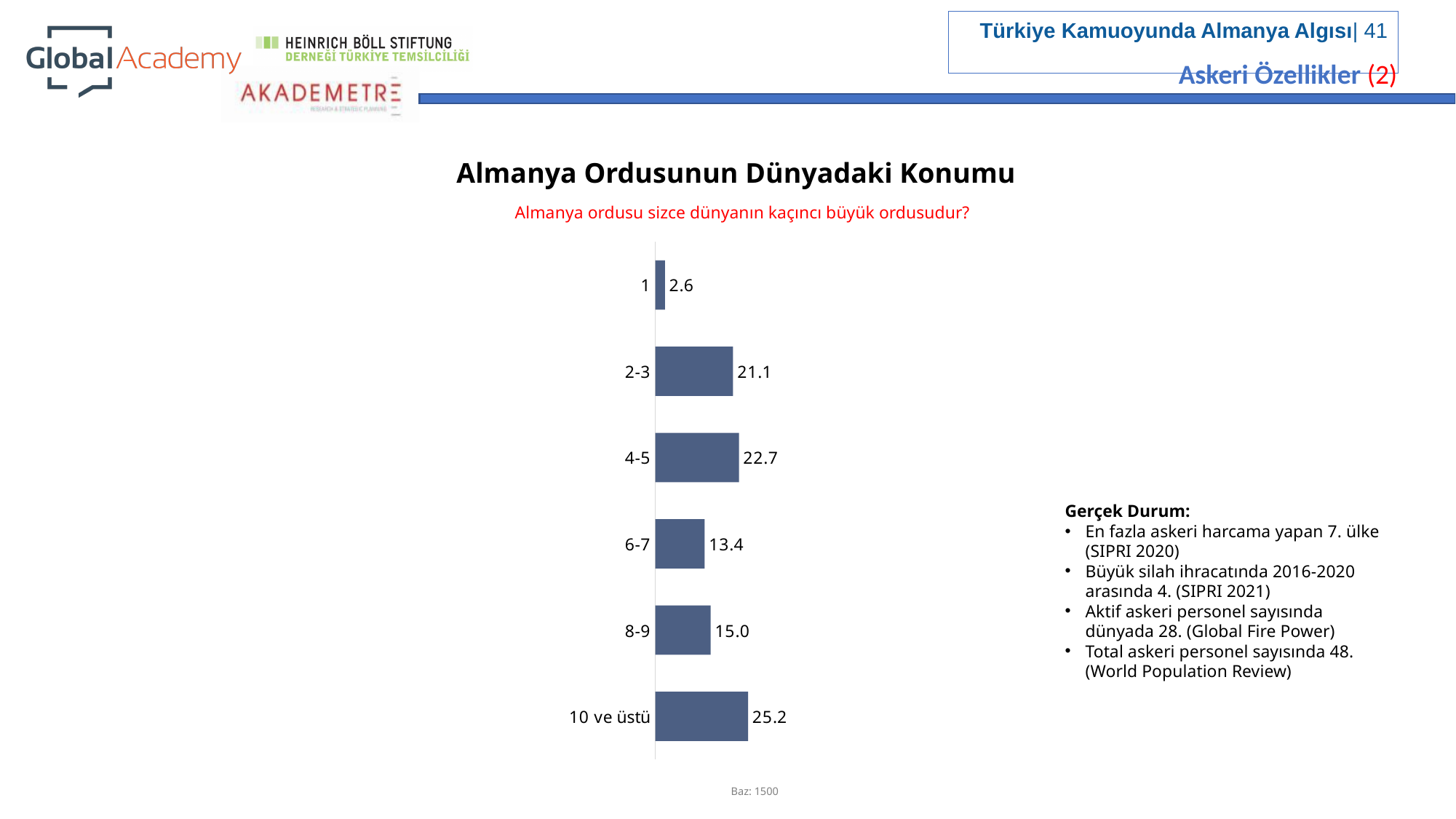
What kind of chart is shown on the slide? bar chart Which category has the lowest value? 1 What is the base (Baz) sample size noted below the chart? 1500 What is the difference between the values for "10 ve üstü" and "1"? 22.6 What is the value for the category "10 ve üstü"? 25.2 Which category has the highest value? 10 ve üstü Which is larger, the value for "8-9" or the value for "6-7"? 8-9 What is the value for the category "6-7"? 13.4 What is the difference between the values for "4-5" and "2-3"? 1.6 What is the value for the category "2-3"? 21.1 How many categories are shown in the chart? 6 What is the title of the chart? Almanya Ordusunun Dünyadaki Konumu